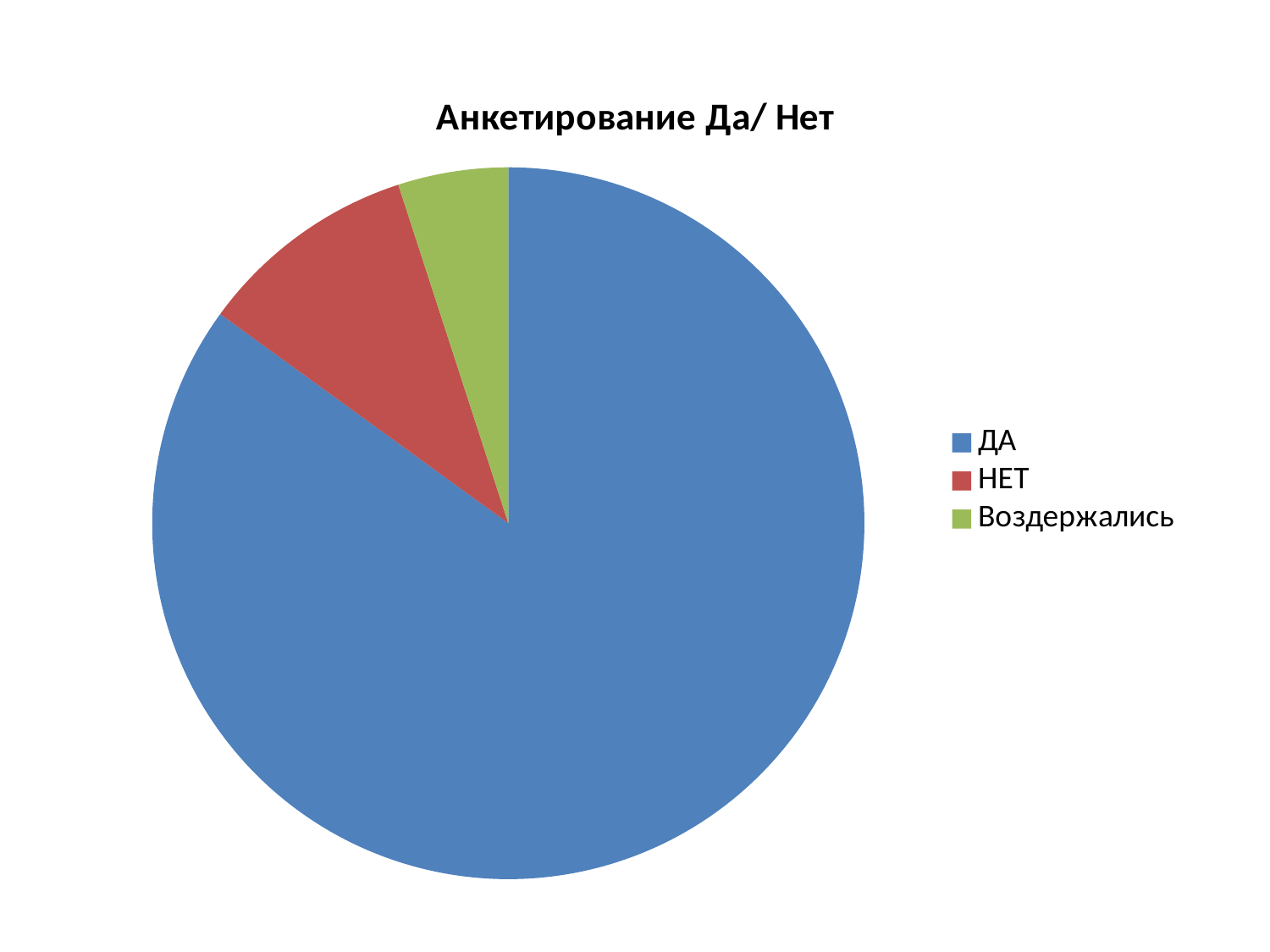
What is the title of the chart? Анкетирование Да/ Нет Which category has the smallest slice of the pie? Воздержались How many slices does the pie chart have? 3 Which slice is larger, ДА or НЕТ? ДА Which category has the largest slice of the pie? ДА How many entries does the legend list? 3 Does the ДА slice take up more or less than half of the pie? more Which slice is larger, НЕТ or Воздержались? НЕТ What kind of chart is shown on the slide? pie chart What colour is the slice for ДА? blue